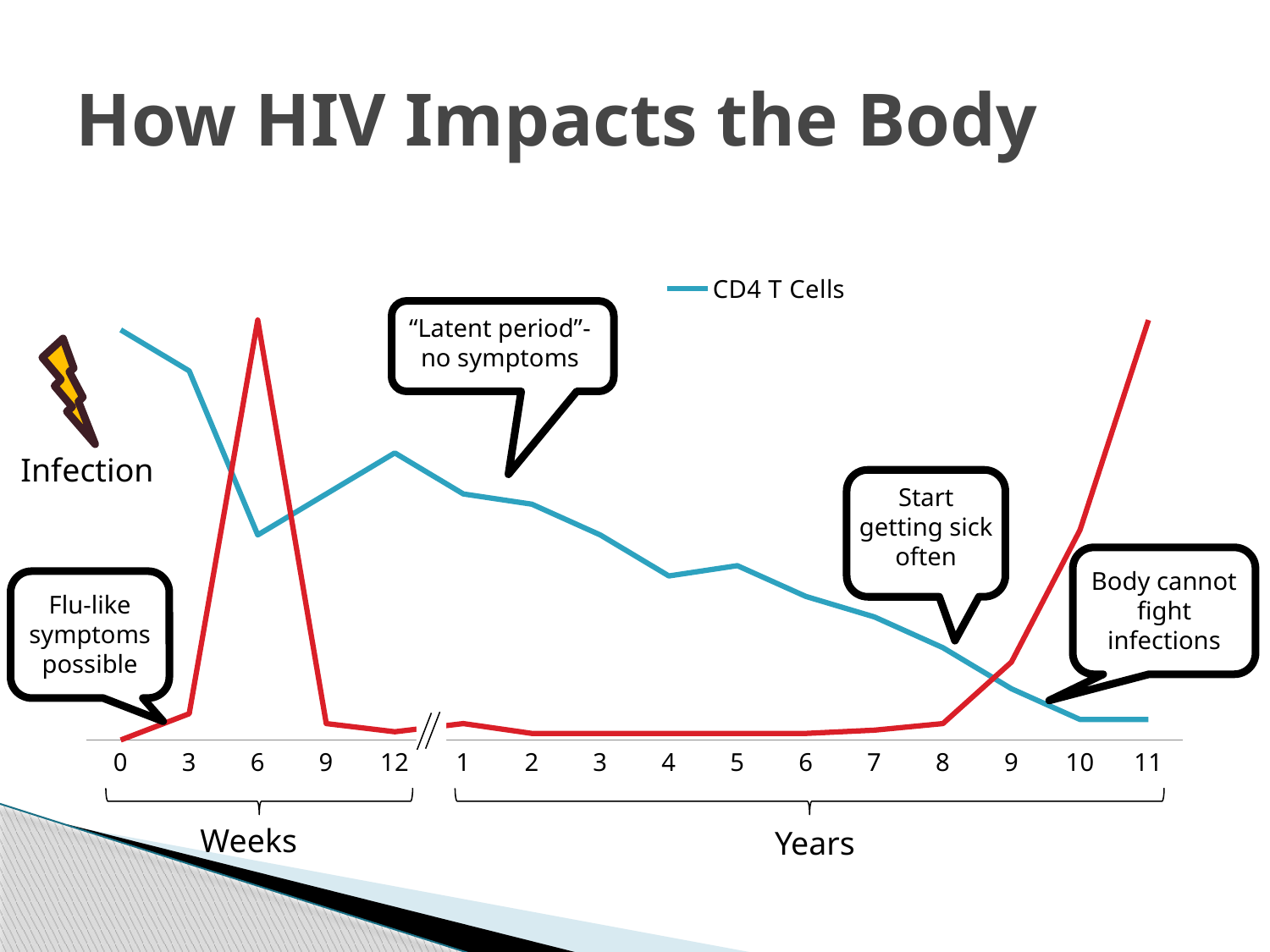
Does the CD4 T Cells line rise or fall across the years section of the x axis (from year 1 to year 11)? fall How many series does the chart's legend list? 1 At week 0, which line is higher: the CD4 T Cells line or the red line? CD4 T Cells Within the weeks section of the x axis, at which tick does the red line reach its peak? 6 What series name appears in the chart's legend? CD4 T Cells How many tick labels are shown along the x axis of the chart? 16 What kind of chart is shown on the slide? line chart What are the two time-unit labels shown beneath the x axis of the chart? Weeks and Years At year 11, which line is higher: the red line or the CD4 T Cells line? the red line Does the red line rise or fall from year 8 to year 11 on the x axis? rise Does the CD4 T Cells line rise or fall between week 0 and week 6? fall